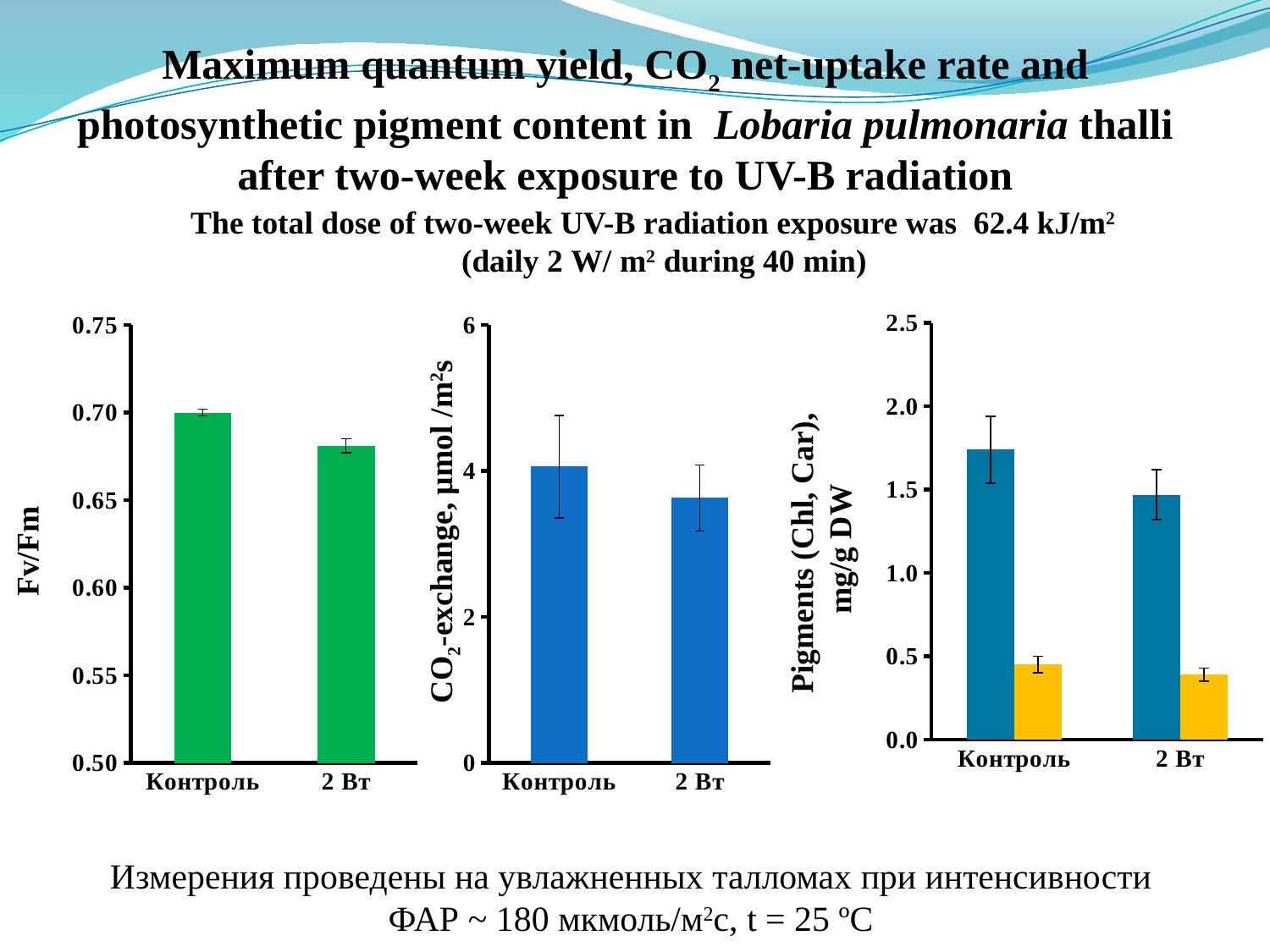
What is the y-axis label of the left chart? Fv/Fm In the right chart (Pigments), is the yellow bar for 2 Вт greater or less than 0.5? less In the right chart (Pigments), is the blue bar for Контроль greater or less than 1.5? greater In the left chart (Fv/Fm), is the value for 2 Вт greater or less than 0.70? less How many categories are shown on the x axis of the middle chart (CO2-exchange)? 2 In the middle chart (CO2-exchange), which category has the lower value? 2 Вт What kind of chart is the left chart (Fv/Fm)? bar chart In the left chart (Fv/Fm), which category has the higher value, Контроль or 2 Вт? Контроль In the right chart (Pigments), which category has the taller blue bar, Контроль or 2 Вт? Контроль In the middle chart, do the values rise or fall from Контроль to 2 Вт? fall